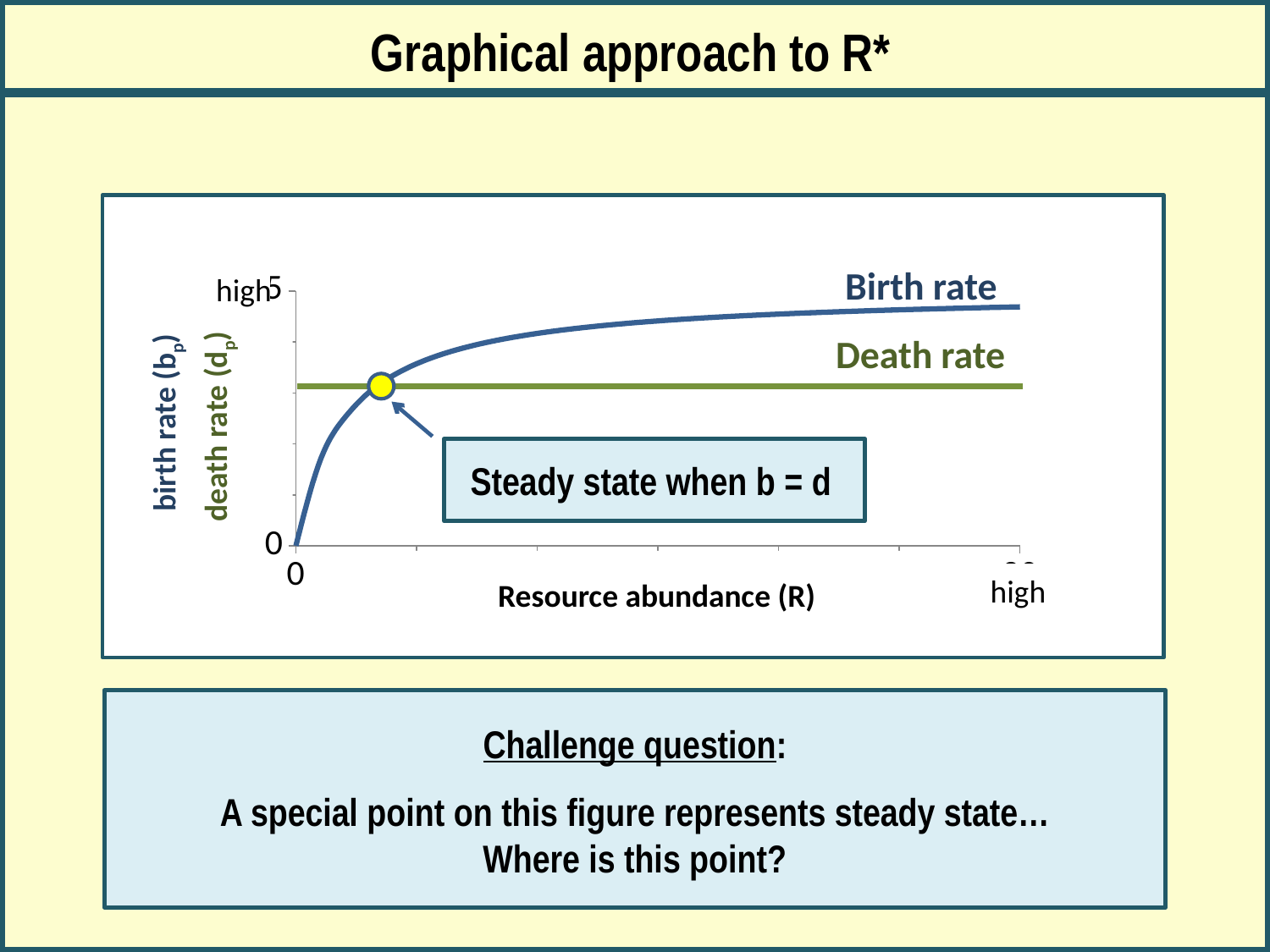
What does the yellow point where the Birth rate curve crosses the Death rate line represent, according to the chart annotation? Steady state when b = d Does the Birth rate curve rise or fall as Resource abundance (R) increases? Rises What is the x-axis label of the chart? Resource abundance (R) At very low Resource abundance (R), near 0, which is larger: the Birth rate or the Death rate? Death rate What is the title of the slide containing the chart? Graphical approach to R* What is the value of the Birth rate curve at Resource abundance (R) = 0? 0 Does the Death rate line rise, fall, or stay flat as Resource abundance (R) increases? Stays flat How many series are plotted in the chart? 2 What are the names of the two series plotted in the chart? Birth rate and Death rate At high Resource abundance (R), which is larger: the Birth rate or the Death rate? Birth rate What type of chart is shown on the slide? Line chart Is the Death rate value greater or less than 5 on the y-axis? less